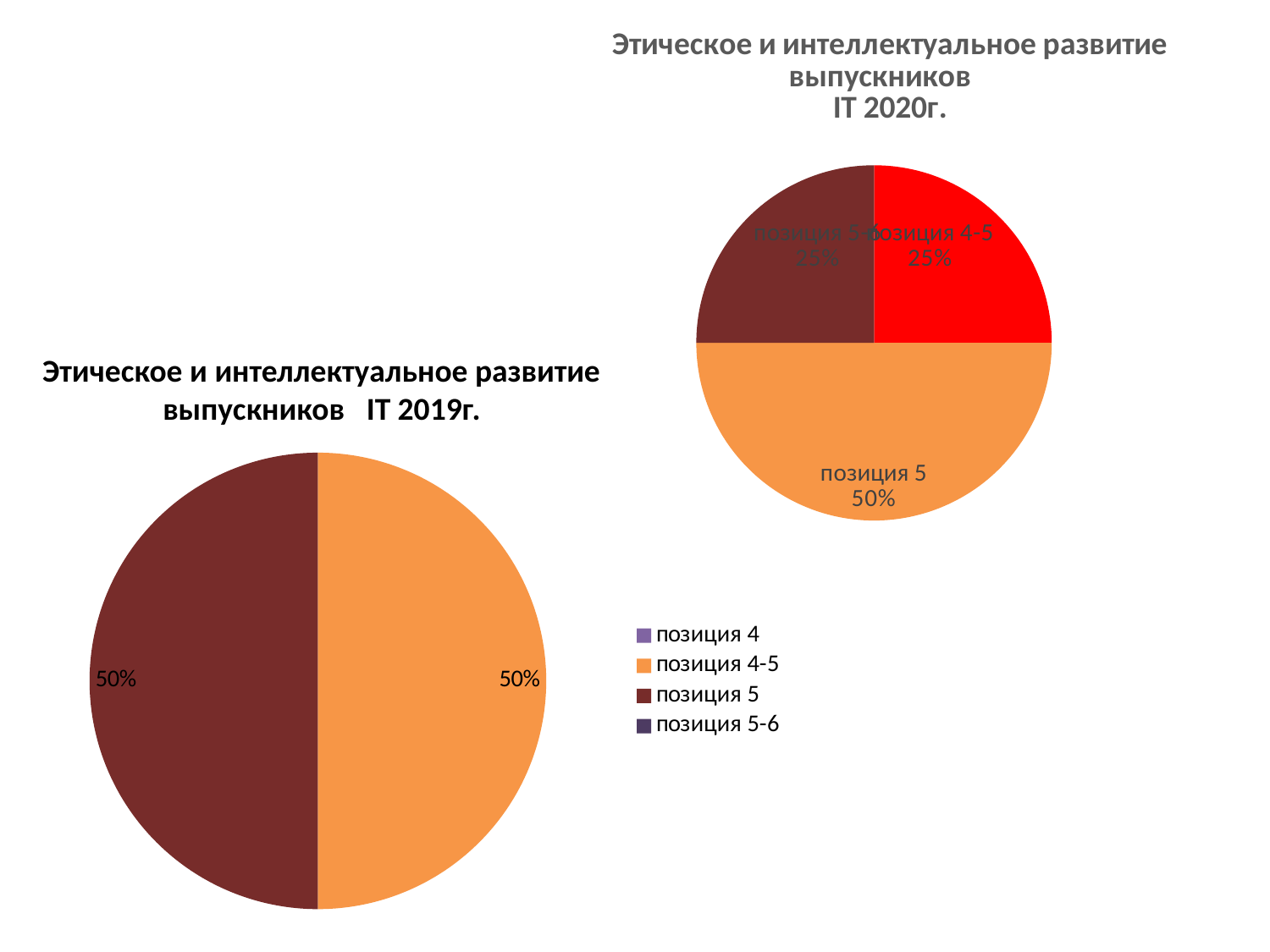
What kind of chart is the 'Этическое и интеллектуальное развитие выпускников IT 2019г.' chart on the left? Pie chart In the 'IT 2020г.' pie chart on the right, what share is labelled for 'позиция 4-5'? 25% How many slices does the 'IT 2019г.' pie chart on the left have? 2 In the 'IT 2020г.' pie chart on the right, is the 'позиция 4-5' slice larger or smaller than the 50% slice? Smaller How many entries does the legend on the slide list? 4 In the 'IT 2019г.' pie chart on the left, what share does the dark red slice have? 50% In the 'IT 2020г.' pie chart on the right, what is the difference between the 50% slice and the 'позиция 4-5' slice? 25% Which colour does the legend assign to 'позиция 4-5'? Orange What is the title of the pie chart on the right? Этическое и интеллектуальное развитие выпускников IT 2020г. How many slices does the 'IT 2020г.' pie chart on the right have? 3 In the 'IT 2019г.' pie chart on the left, what share does the orange slice have? 50% In the 'IT 2020г.' pie chart on the right, what is the share of the largest slice? 50%